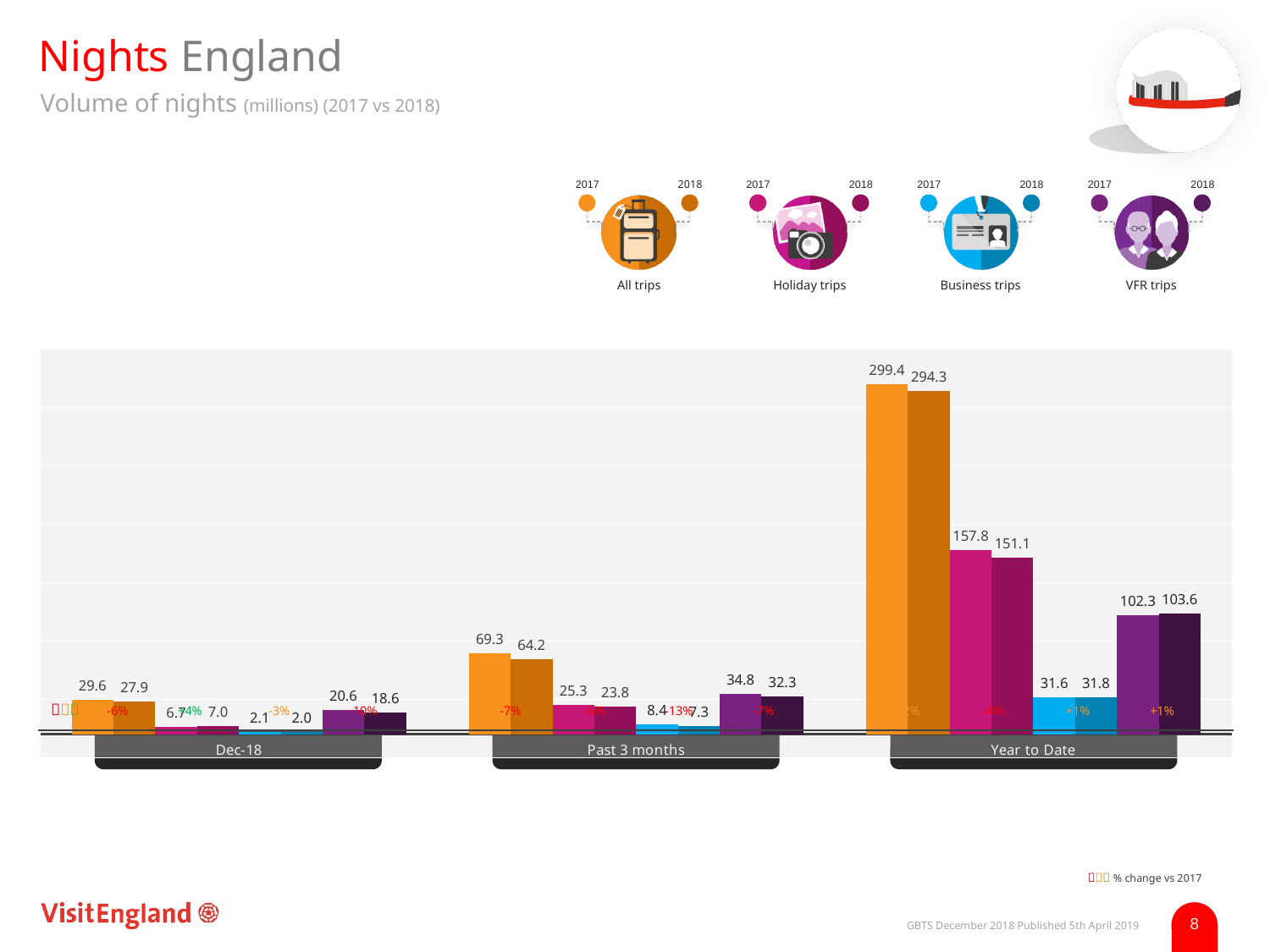
In the Year to Date group, is the 2018 value for VFR trips larger or smaller than the 2017 value? larger What is the Dec-18 volume of nights for VFR trips in 2018? 18.6 How many trip types are shown in the chart? 4 What is the difference between the 2017 and 2018 Year to Date values for Holiday trips? 6.7 Which bar in the chart has the highest value? All trips 2017, Year to Date (299.4) What is the Year to Date volume of nights for All trips in 2018? 294.3 What is the Past 3 months volume of nights for Holiday trips in 2017? 25.3 What kind of chart is shown on the slide? bar chart How many time-period groups are shown on the x axis of the chart? 3 What is the difference between the 2017 and 2018 Past 3 months values for All trips? 5.1 What is the Year to Date volume of nights for Business trips in 2017? 31.6 Which trip type has the lowest volume of nights in the Dec-18 group? Business trips